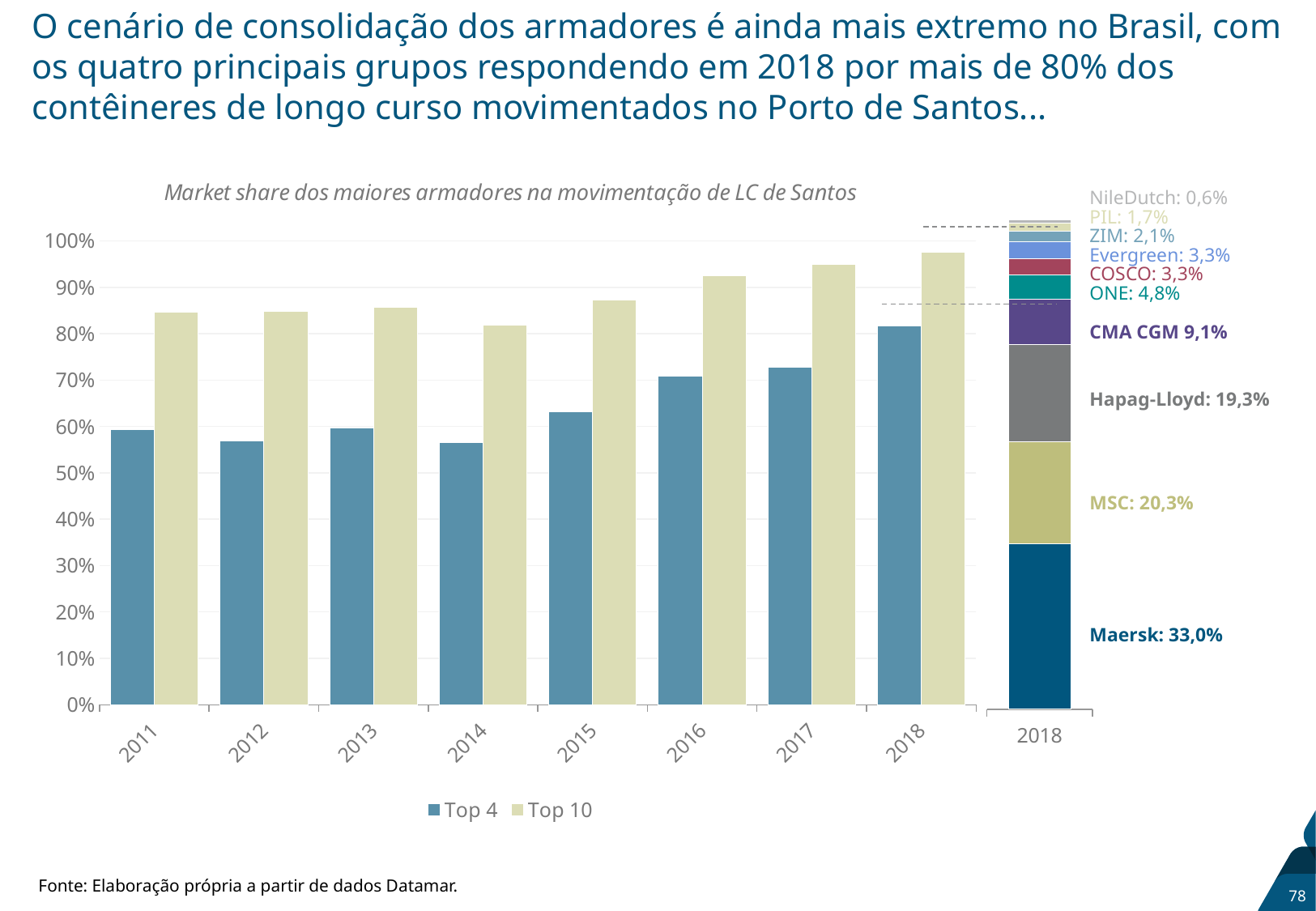
In the stacked 2018 bar on the right, which shipping line has the smallest share? NileDutch In the stacked 2018 bar on the right, what is the combined share of the four largest lines (Maersk, MSC, Hapag-Lloyd and CMA CGM)? 81,7% In the grouped bar chart, is the Top 4 value for 2014 greater or less than 60%? less How many series does the legend of the grouped bar chart list? 2 How many years are shown on the x axis of the grouped bar chart? 8 In the stacked 2018 bar on the right, what is Hapag-Lloyd's market share? 19,3% In the stacked 2018 bar on the right, which shipping line has the largest share? Maersk In the grouped bar chart, which year has the highest Top 4 value? 2018 In the grouped bar chart, is the Top 10 value for 2016 greater or less than 90%? greater In the stacked 2018 bar on the right, what is Maersk's market share? 33,0% In the stacked 2018 bar on the right, what is the difference between Maersk's share and MSC's share? 12,7% In the grouped bar chart, is the Top 4 value larger in 2015 or in 2016? 2016